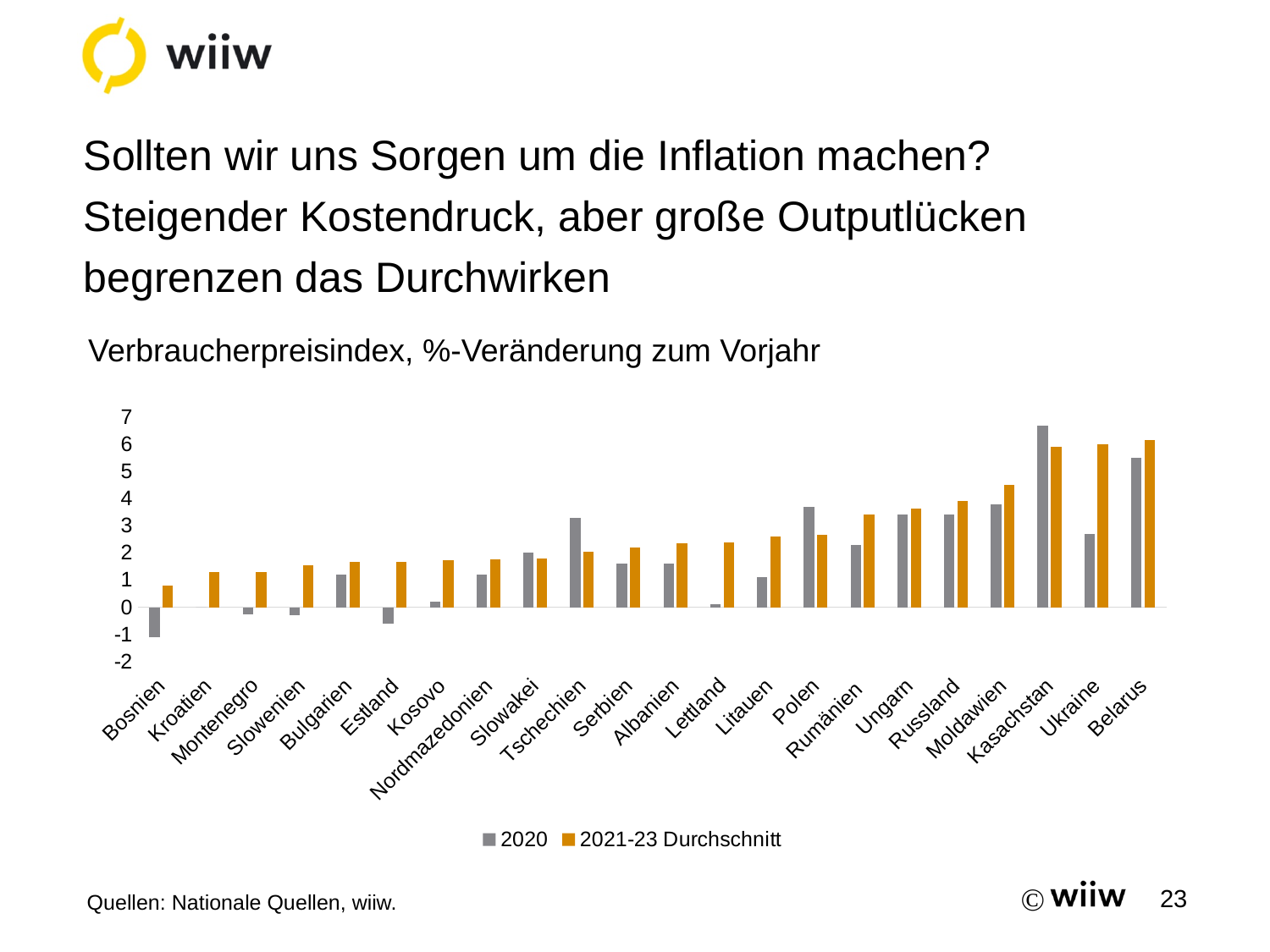
For Polen, which is larger: the 2020 value or the 2021-23 Durchschnitt value? 2020 Is the 2020 value for Bosnien greater or less than 0? less Is the 2020 value for Kasachstan greater or less than 6? greater For Rumänien, which is larger: the 2020 value or the 2021-23 Durchschnitt value? 2021-23 Durchschnitt What kind of chart is shown on the slide? bar chart Which country has the lowest value for 2020? Bosnien Do the 2021-23 Durchschnitt values generally rise or fall from left to right along the x axis? rise How many series does the legend list? 2 Which country has the lowest value for 2021-23 Durchschnitt? Bosnien Which country has the highest value for 2020? Kasachstan Is the 2021-23 Durchschnitt value for Ukraine greater or less than 5? greater How many countries are shown on the x axis? 22